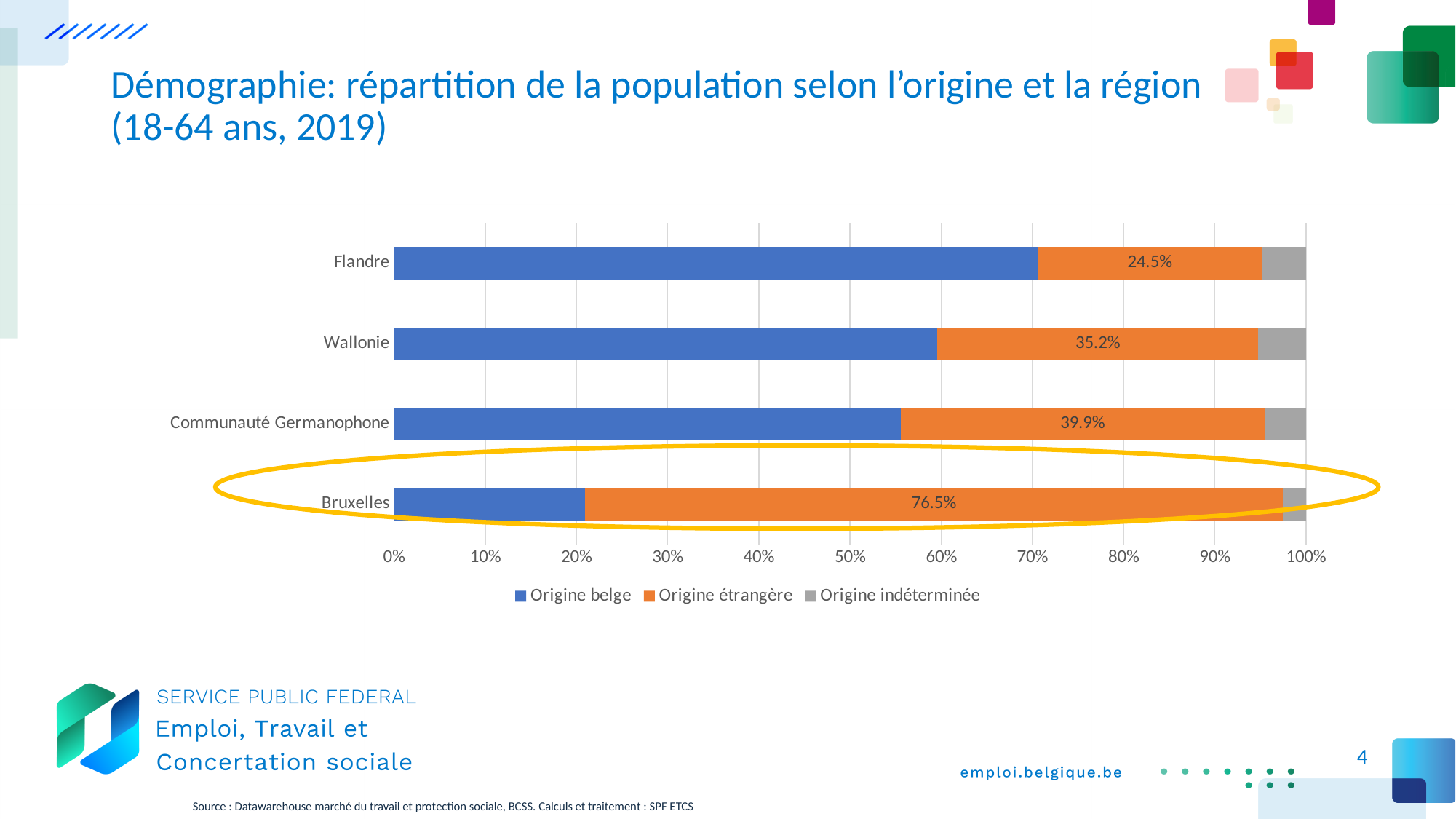
Which region has the highest share of 'Origine étrangère'? Bruxelles What share of the population in Bruxelles is of 'Origine étrangère'? 76.5% What type of chart is shown on the slide? Stacked bar chart What is the 'Origine étrangère' value for Wallonie? 35.2% How many series does the legend list? 3 What is the 'Origine étrangère' value for Communauté Germanophone? 39.9% How many regions are shown in the chart? 4 What is the 'Origine étrangère' value for Flandre? 24.5% What is the difference between the 'Origine étrangère' shares of Bruxelles and Flandre? 52 percentage points Is the 'Origine belge' share for Flandre greater or less than 60%? greater Which region has the lowest share of 'Origine étrangère'? Flandre Which has a larger 'Origine étrangère' share, Wallonie or Communauté Germanophone? Communauté Germanophone